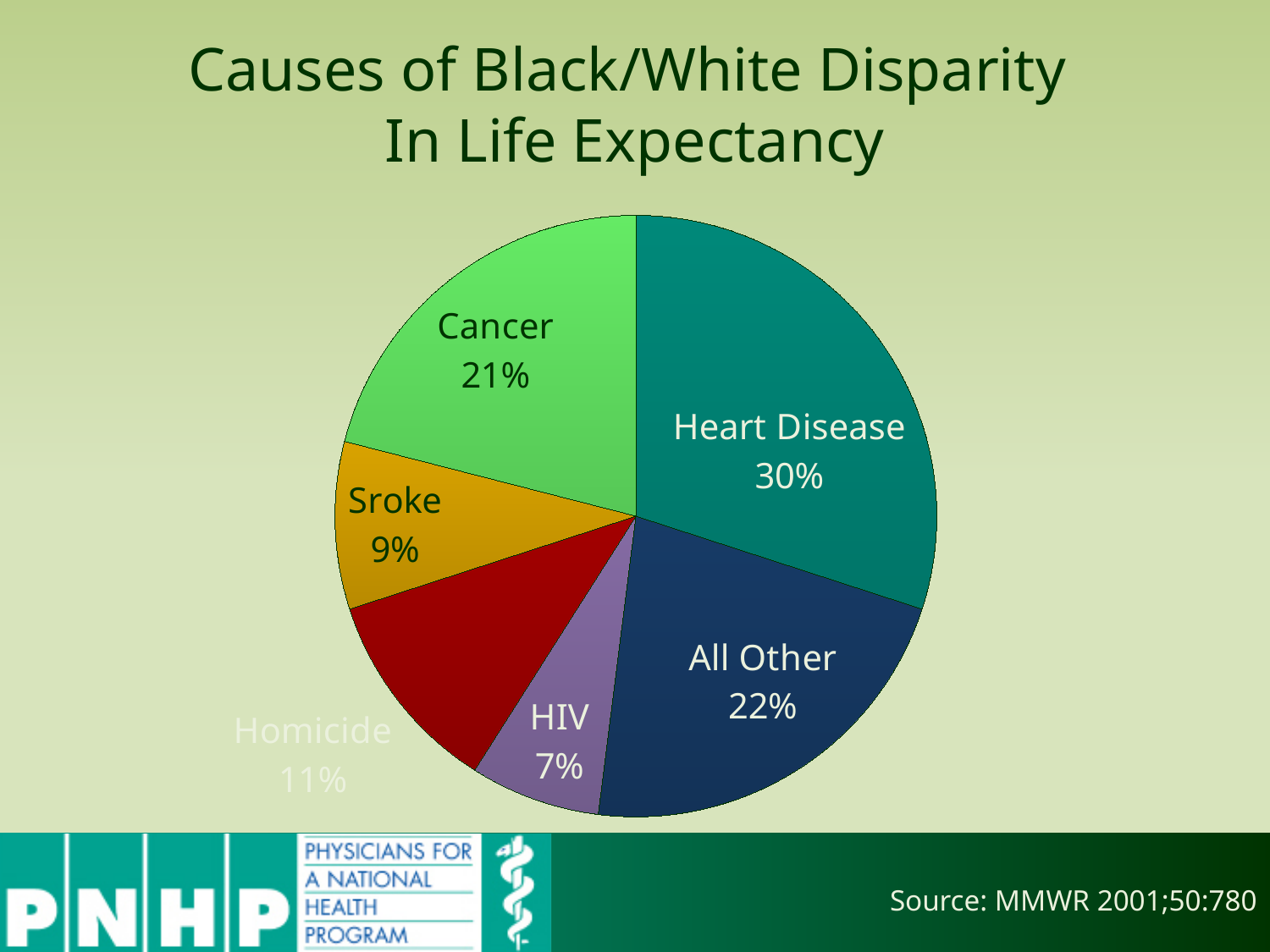
What percentage is shown for HIV? 7% Which is larger, the share for All Other or the share for Cancer? All Other What is the difference in percentage points between Heart Disease and Cancer? 9 What share of the pie does Heart Disease account for? 30% What percentage is shown for Cancer? 21% What kind of chart is shown on the slide? Pie chart What is the title of the chart? Causes of Black/White Disparity In Life Expectancy How many slices does the pie chart have? 6 Which cause has the largest slice of the pie? Heart Disease What percentage is shown for the slice labelled Sroke? 9% Which cause has the smallest slice of the pie? HIV What percentage is shown for All Other? 22%